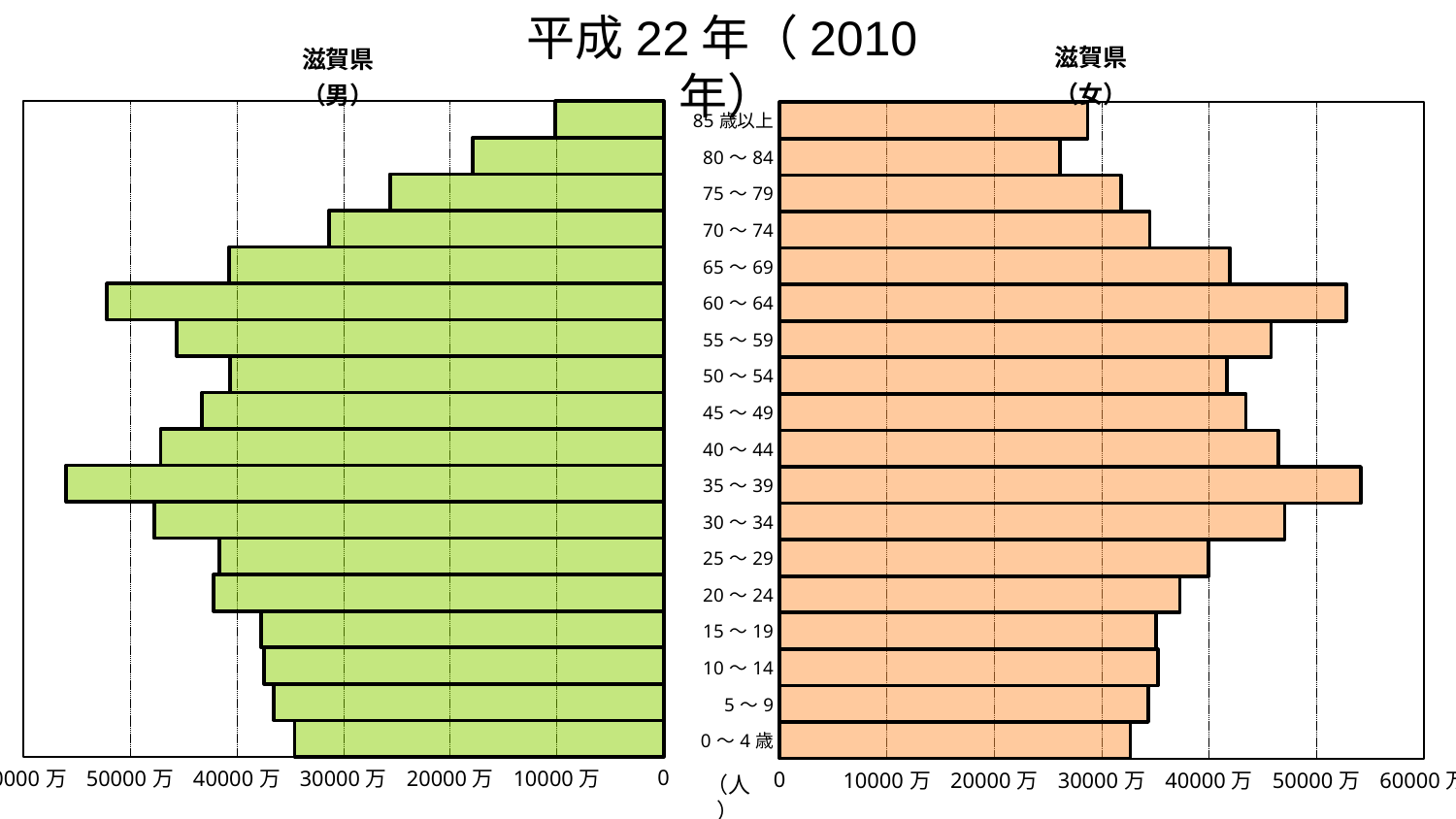
In the 滋賀県（女） chart, is the value for 35～39 greater or less than 50000万? greater In the 滋賀県（男） chart, is the value for 85歳以上 greater or less than 20000万? less In the 滋賀県（男） chart, is the value for 60～64 greater or less than 40000万? greater What is the title of the slide's chart? 平成22年（2010年） What kind of chart is shown on the slide? bar chart In the 滋賀県（男） chart, which age group has the shortest bar? 85歳以上 In the 滋賀県（女） chart, which age group has the shortest bar? 80～84 Which bar is longer: 85歳以上 in the 滋賀県（男） chart or 85歳以上 in the 滋賀県（女） chart? 滋賀県（女） In the 滋賀県（男） chart, which age group has the longest bar? 35～39 In the 滋賀県（男） chart, which is larger, the value for 35～39 or the value for 60～64? 35～39 How many age groups are plotted in the 滋賀県（男） chart? 18